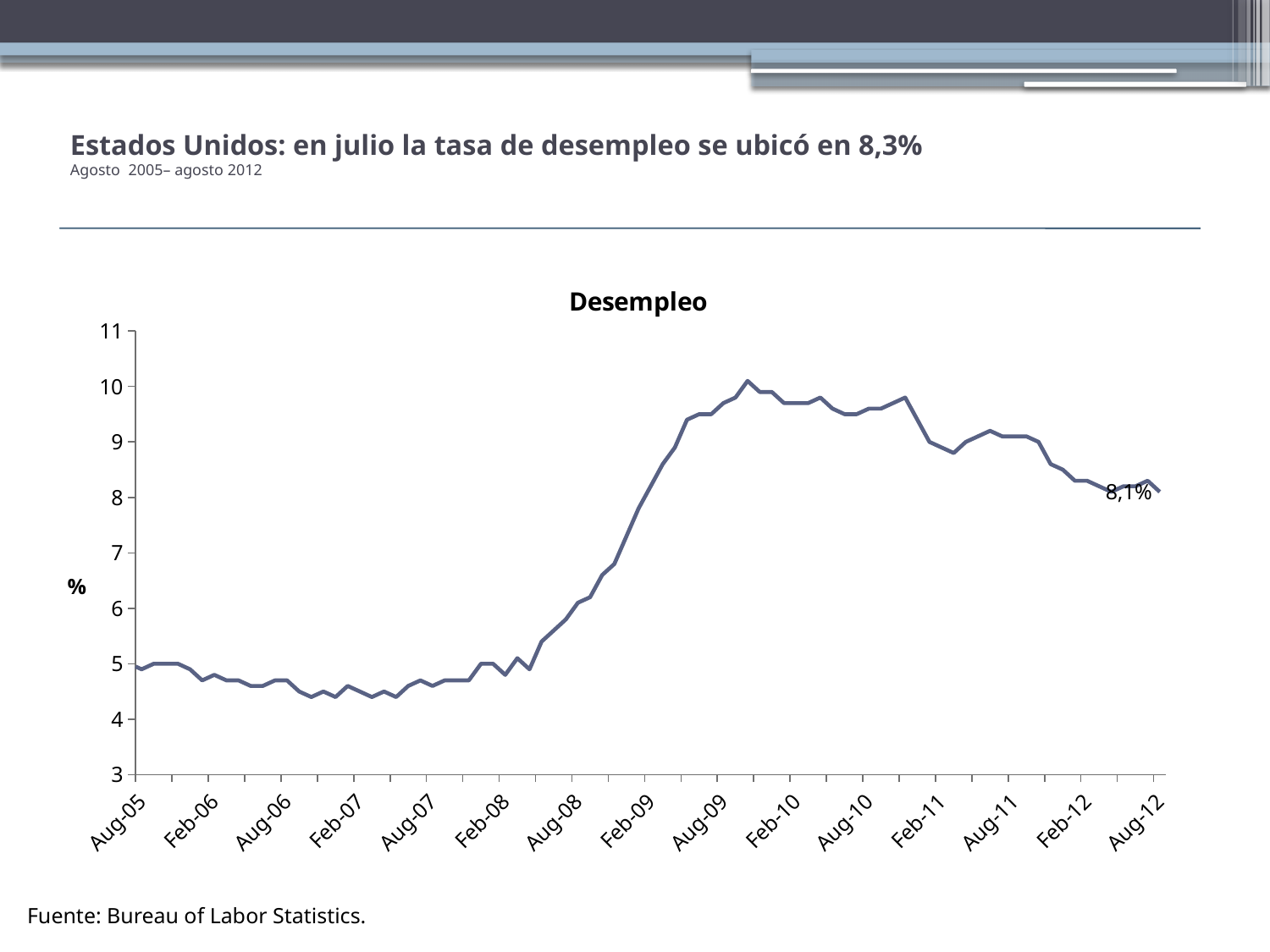
Is the lowest value on the line greater or less than 5? less What is the label on the vertical axis of the chart? % Is the value for Aug-11 greater or less than 8? greater Does the line rise or fall between Feb-08 and Aug-09? rise Which is larger, the value for Aug-09 or the value for Aug-05? Aug-09 Is the value for Feb-08 greater or less than 6? less What kind of chart is shown on the slide? line chart How many date labels are shown on the horizontal axis? 15 What is the title of the chart? Desempleo What value is labelled at the end of the line, at Aug-12? 8,1%